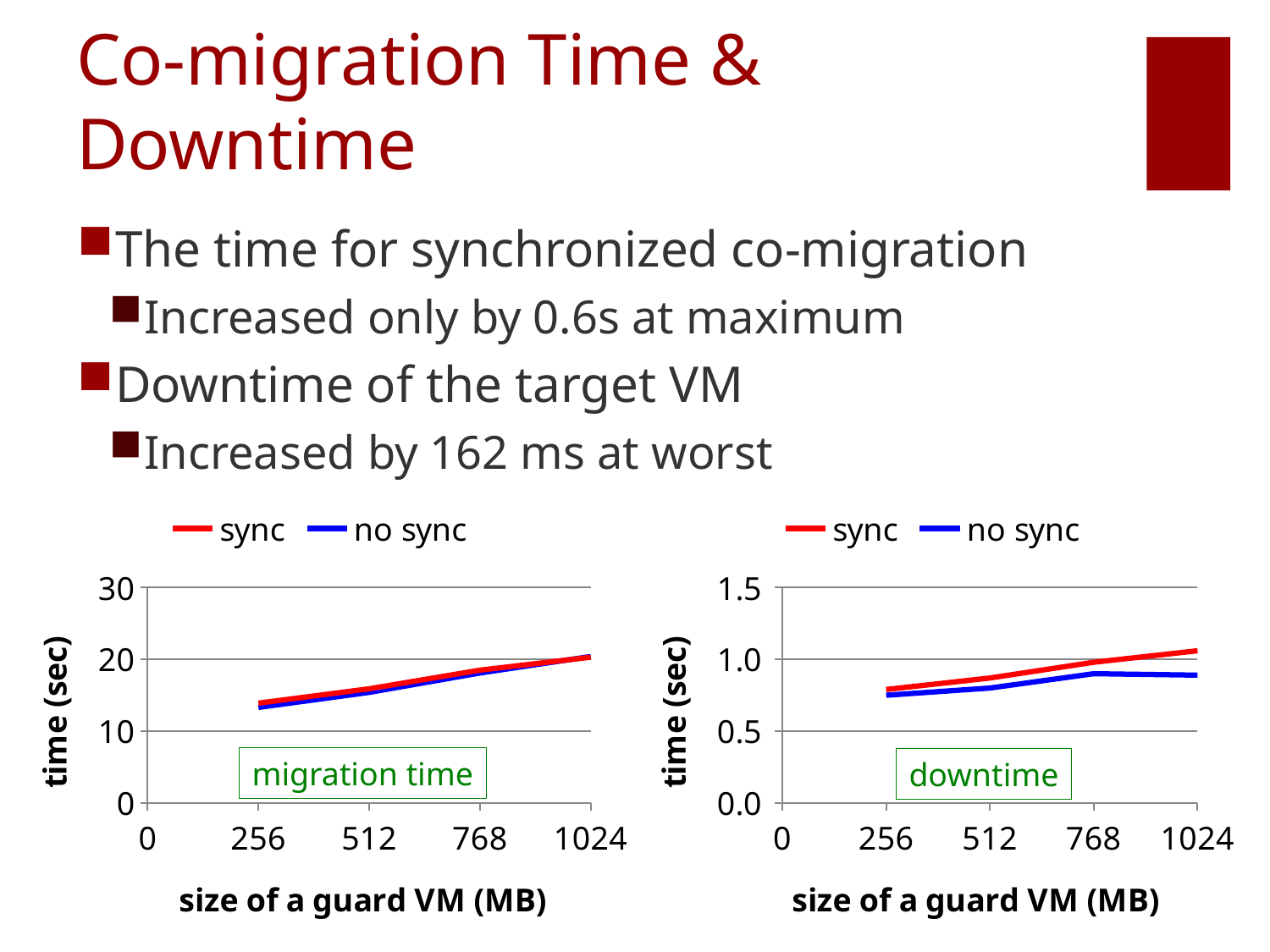
In the migration time chart, is the sync value at 256 MB greater or less than 20? less What colour is the no sync line in the migration time chart? blue In the downtime chart, does the sync line rise or fall as the size of the guard VM increases? rise In the downtime chart, is the sync value at 256 MB greater or less than 0.5? greater How many series does the legend of the downtime chart list? 2 What kind of chart is the migration time chart on the left? line chart In the migration time chart, how many guard VM sizes are plotted for each series? 4 In the downtime chart, is the no sync value at 1024 MB greater or less than 1.0? less What is the label on the y axis of the downtime chart? time (sec) In the migration time chart, does the sync line rise or fall as the size of the guard VM increases? rise In the downtime chart, which series has the larger value at 1024 MB, sync or no sync? sync